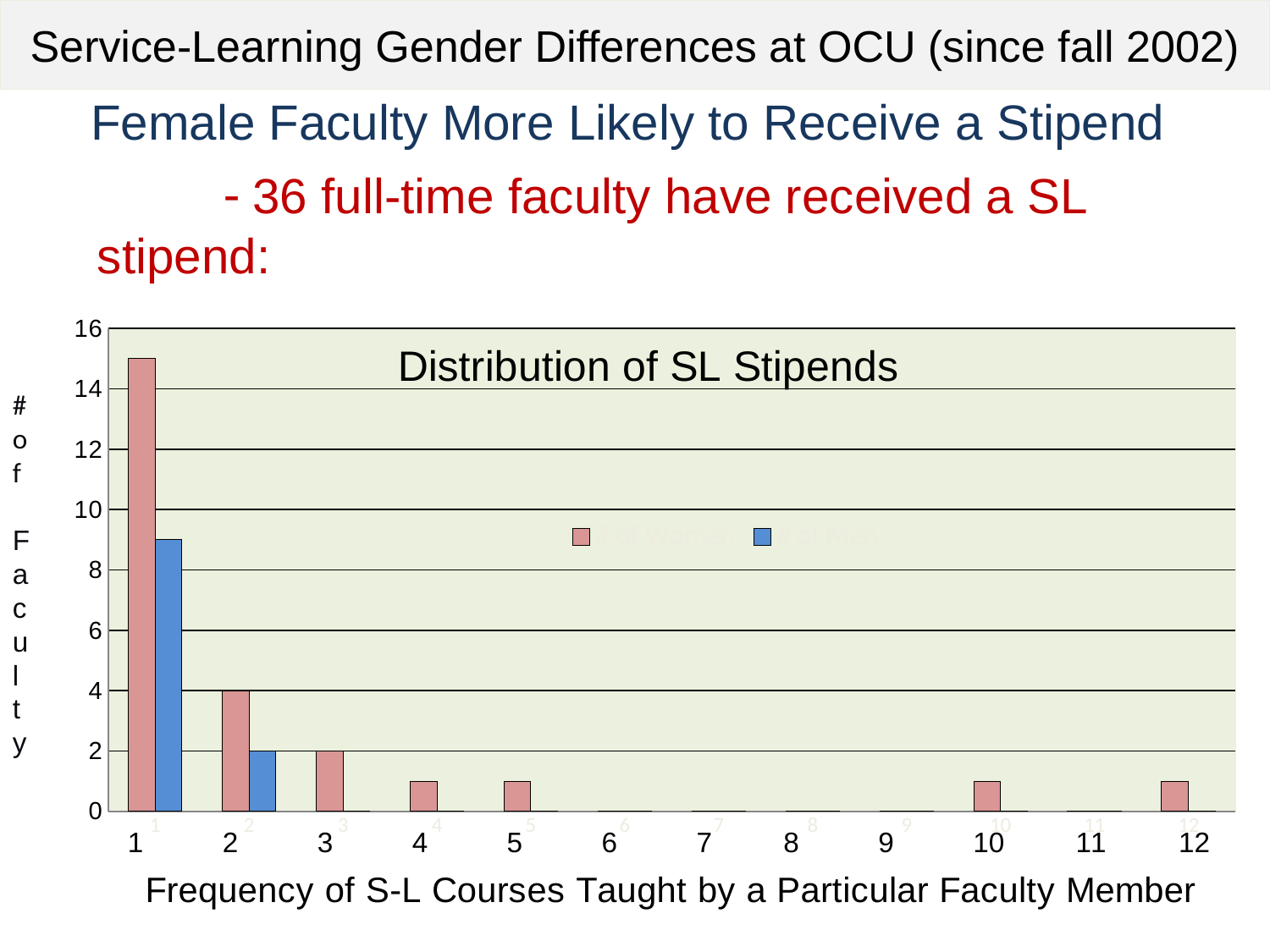
How many series does the chart's legend list? 2 At which frequency is the # of Women value highest? 1 What is the value for # of Women at frequency 2? 4 What is the title of the chart? Distribution of SL Stipends What is the value for # of Men at frequency 2? 2 What is the difference between # of Women and # of Men at frequency 2? 2 Is the value for # of Women at frequency 1 greater or less than 14? greater How many categories are shown along the x axis of the chart? 12 At frequency 1, which is larger: # of Women or # of Men? # of Women Is the value for # of Men at frequency 1 greater or less than 10? less What kind of chart is shown on the slide? bar chart What is the value for # of Women at frequency 3? 2